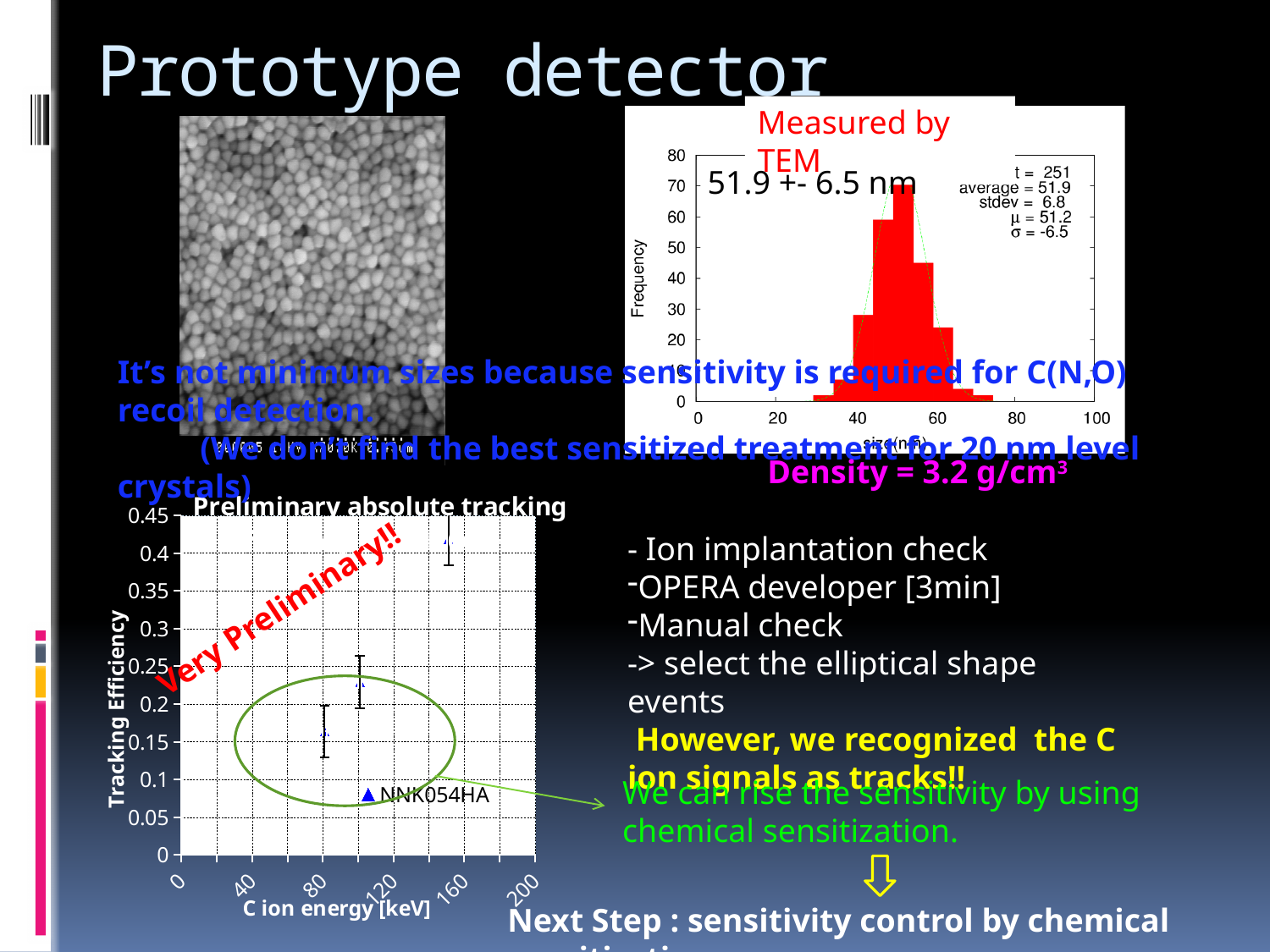
What average size is printed in the statistics box of the 'Measured by TEM' histogram? 51.9 What kind of chart is the top-right 'Measured by TEM' chart? bar chart (histogram) In the 'Preliminary absolute tracking' chart, is the tracking efficiency of the point at about 80 keV greater or less than 0.2? less In the 'Preliminary absolute tracking' chart, is the tracking efficiency of the highest-energy point (around 150 keV) greater or less than 0.35? greater How many data points are plotted in the 'Preliminary absolute tracking' chart? 3 How many series does the legend of the 'Preliminary absolute tracking' chart list? 1 What kind of chart is the bottom-left chart titled 'Preliminary absolute tracking'? scatter chart What is the title of the bottom-left chart? Preliminary absolute tracking In the 'Measured by TEM' histogram, is the frequency of the tallest bar greater or less than 60? greater In the 'Preliminary absolute tracking' chart, does the tracking efficiency rise or fall as C ion energy increases? rise What is the name of the series shown in the legend of the 'Preliminary absolute tracking' chart? NNK054HA In the 'Preliminary absolute tracking' chart, which point has the highest tracking efficiency: the one at about 80 keV or the one at about 150 keV? the one at about 150 keV